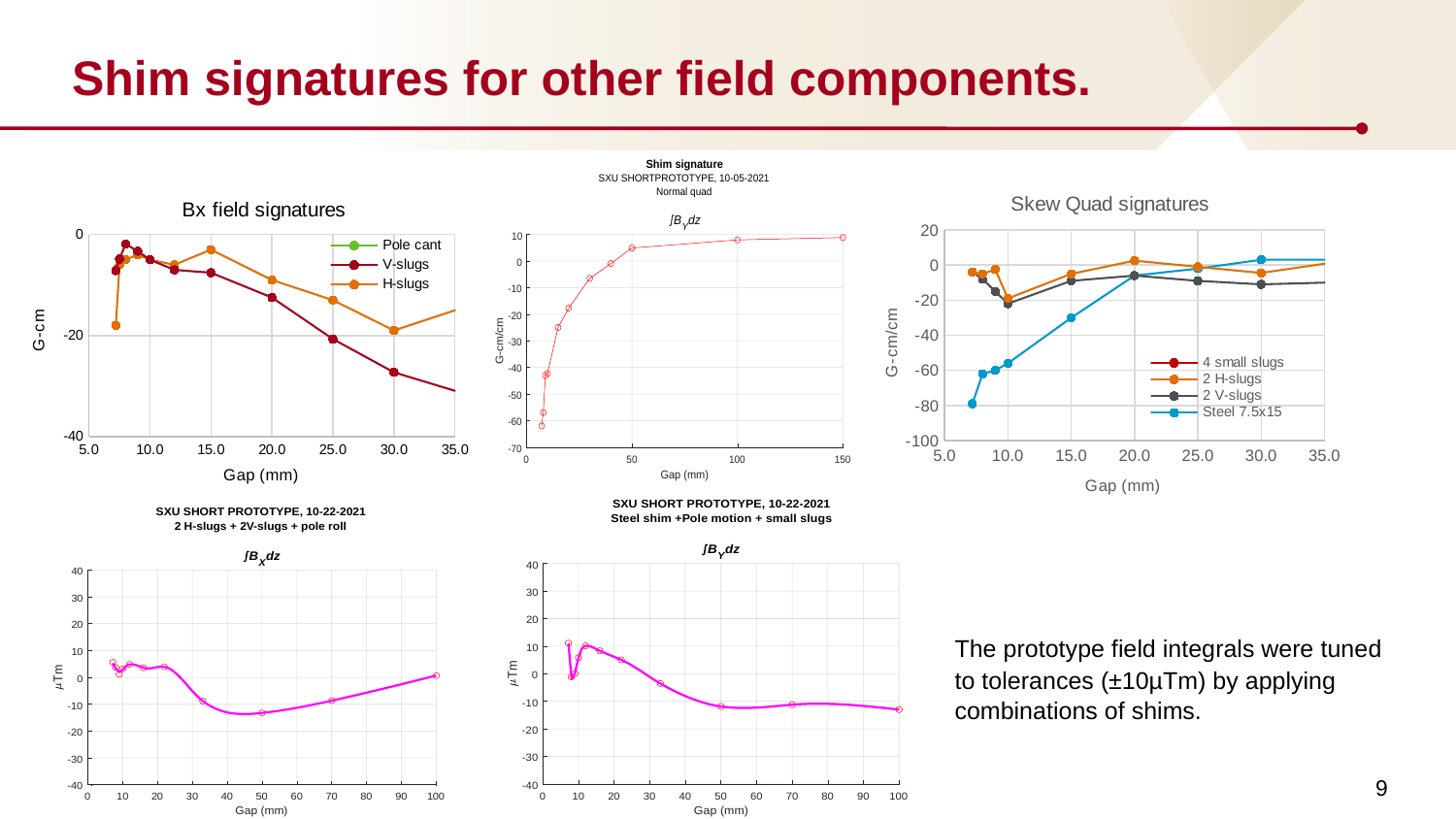
How many series does the legend of the "Skew Quad signatures" chart list? 4 In the "Bx field signatures" chart, do the V-slugs values rise or fall as the gap increases from 10.0 to 35.0 mm? fall In the "Skew Quad signatures" chart, does the Steel 7.5x15 series rise or fall as the gap increases from 7 to 30 mm? rise How many series does the legend of the "Bx field signatures" chart list? 3 In the "Bx field signatures" chart, is the V-slugs value at a gap of 30.0 mm greater or less than -20? less In the "Shim signature" Normal quad chart (top middle), is the value at a gap of 100 mm greater or less than 0? greater In the "Bx field signatures" chart, is the H-slugs value at a gap of 25.0 mm greater or less than -20? greater In the "Shim signature" Normal quad chart (top middle), do the values rise or fall as the gap increases? rise What is the y-axis label of the "Skew Quad signatures" chart? G-cm/cm What type of chart is the "Bx field signatures" chart? line chart